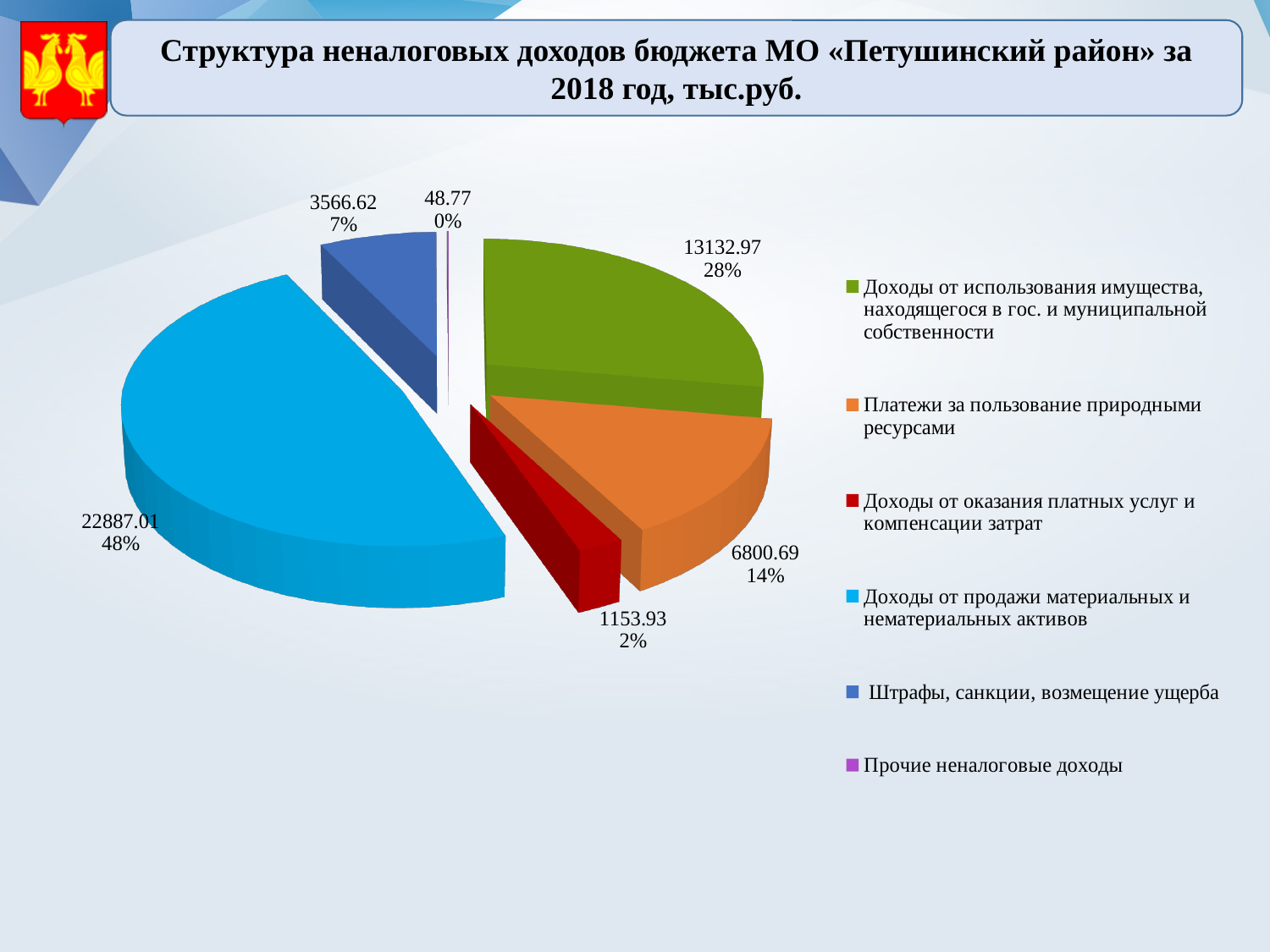
Which category has the smallest slice of the pie? Прочие неналоговые доходы Which category has the largest slice of the pie? Доходы от продажи материальных и нематериальных активов How many categories does the legend list? 6 What share of the pie does «Доходы от оказания платных услуг и компенсации затрат» represent? 2% What is the value for «Прочие неналоговые доходы»? 48.77 What is the value for «Доходы от продажи материальных и нематериальных активов»? 22887.01 Which is larger: «Платежи за пользование природными ресурсами» or «Штрафы, санкции, возмещение ущерба»? Платежи за пользование природными ресурсами What is the difference between the values for «Доходы от продажи материальных и нематериальных активов» and «Доходы от использования имущества, находящегося в гос. и муниципальной собственности»? 9754.04 What is the value for «Платежи за пользование природными ресурсами»? 6800.69 What is the value for «Штрафы, санкции, возмещение ущерба»? 3566.62 What type of chart is shown on the slide? Pie chart What share of the pie does «Доходы от использования имущества, находящегося в гос. и муниципальной собственности» represent? 28%